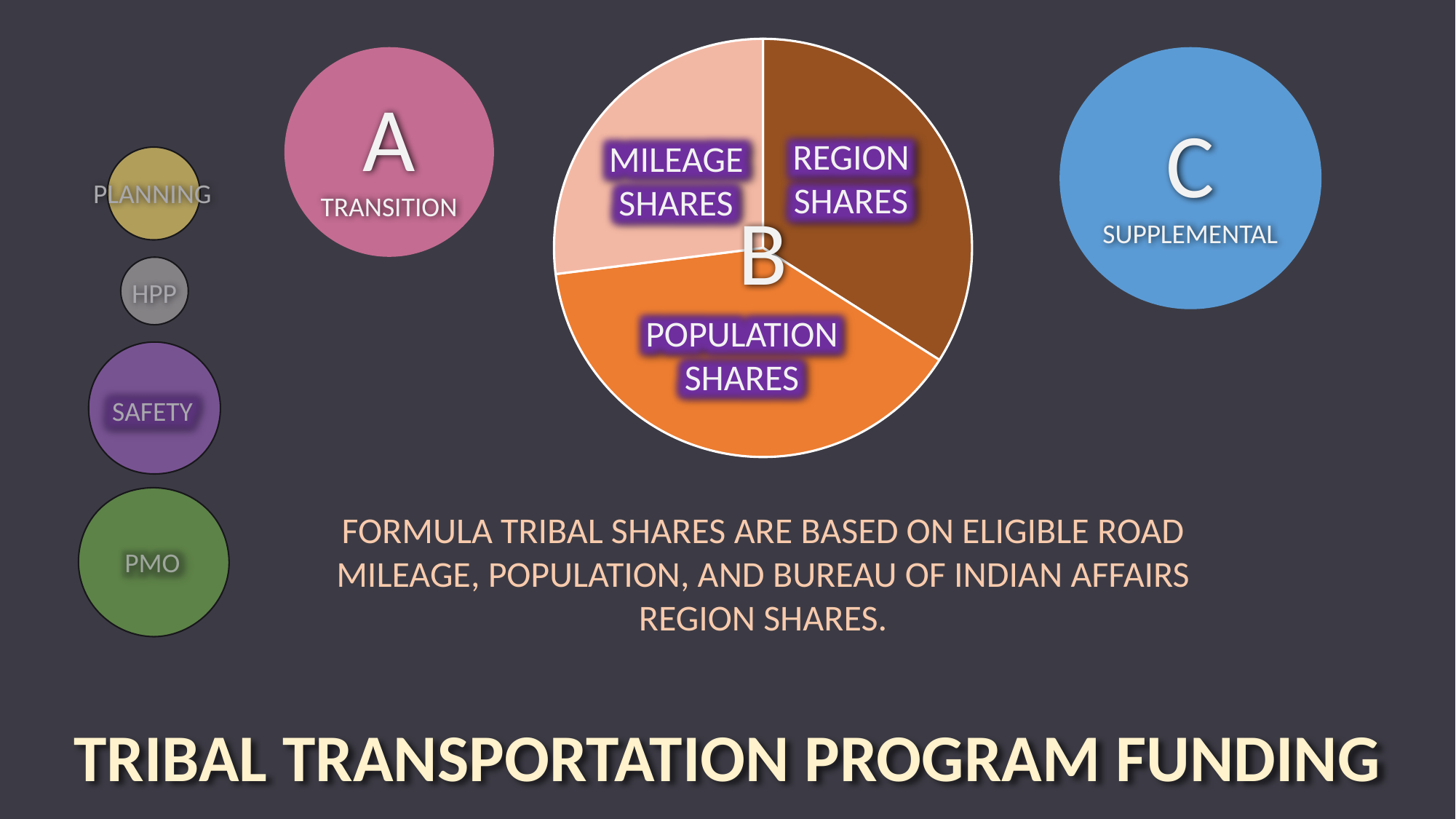
In the pie chart, which slice is larger: Population Shares or Region Shares? Population Shares Which slice of the pie chart is the largest? Population Shares Which slice of the pie chart is the smallest? Mileage Shares What letter is printed at the centre of the pie chart? B In the pie chart, which slice is larger: Region Shares or Mileage Shares? Region Shares How many slices does the pie chart have? 3 What colour is the Population Shares slice of the pie chart? orange What kind of chart is shown in the middle of the slide? pie chart